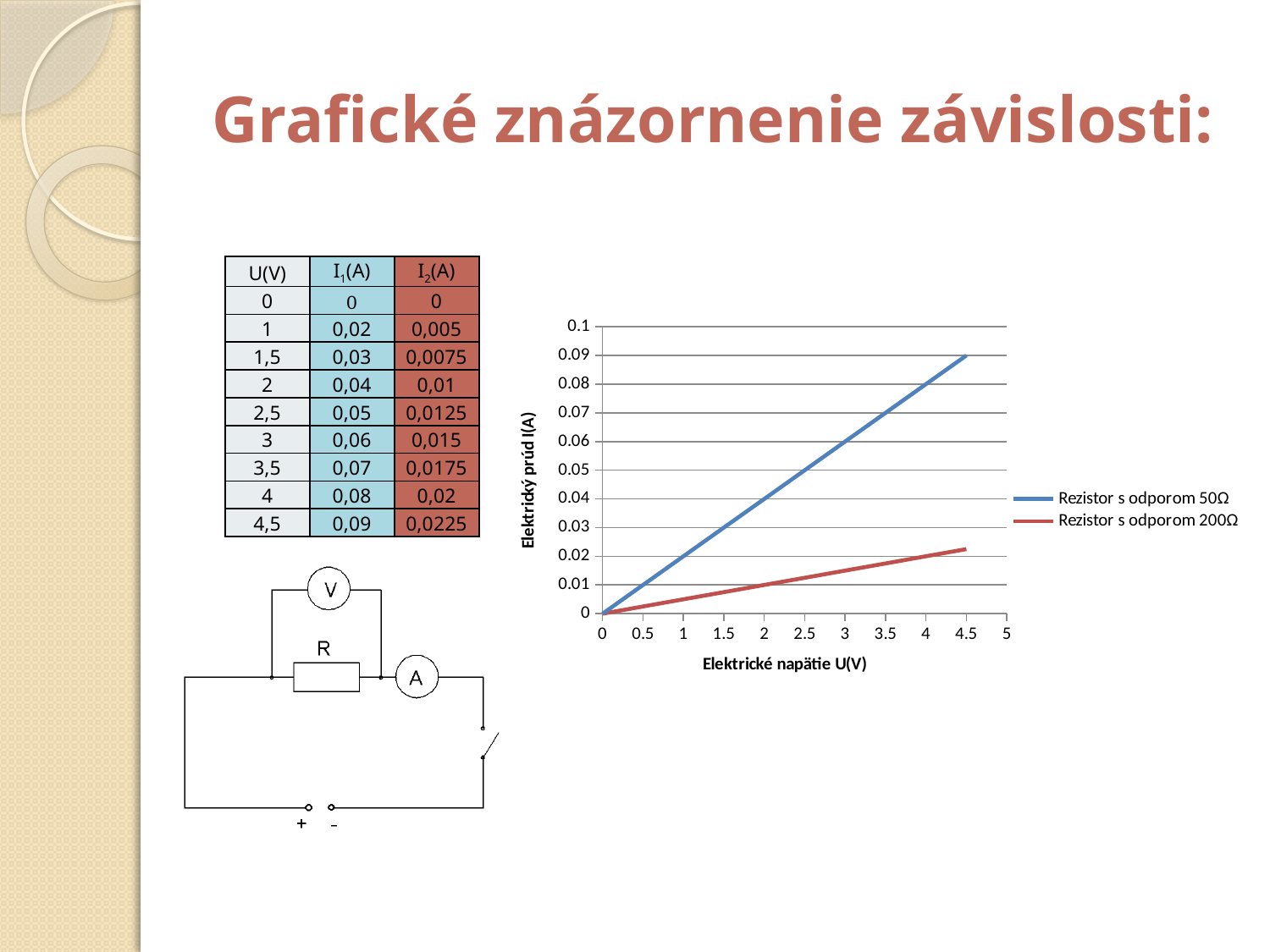
How many series does the chart legend list? 2 At a voltage of 4.5 V, which series has the larger current: 'Rezistor s odporom 50Ω' or 'Rezistor s odporom 200Ω'? Rezistor s odporom 50Ω What is the title of the chart's vertical axis? Elektrický prúd I(A) What is the current for 'Rezistor s odporom 50Ω' at a voltage of 3 V? 0.06 What kind of chart is shown on the slide? line chart Which series is drawn in blue on the chart? Rezistor s odporom 50Ω What is the title of the chart's horizontal axis? Elektrické napätie U(V) Is the value for 'Rezistor s odporom 200Ω' at 4.5 V greater or less than 0.03? less Is the value for 'Rezistor s odporom 50Ω' at 2 V greater or less than 0.03? greater What is the current for 'Rezistor s odporom 200Ω' at a voltage of 4 V? 0.02 What is the current for 'Rezistor s odporom 50Ω' at a voltage of 4.5 V? 0.09 Do the values for 'Rezistor s odporom 50Ω' rise or fall as the voltage increases along the x axis? rise